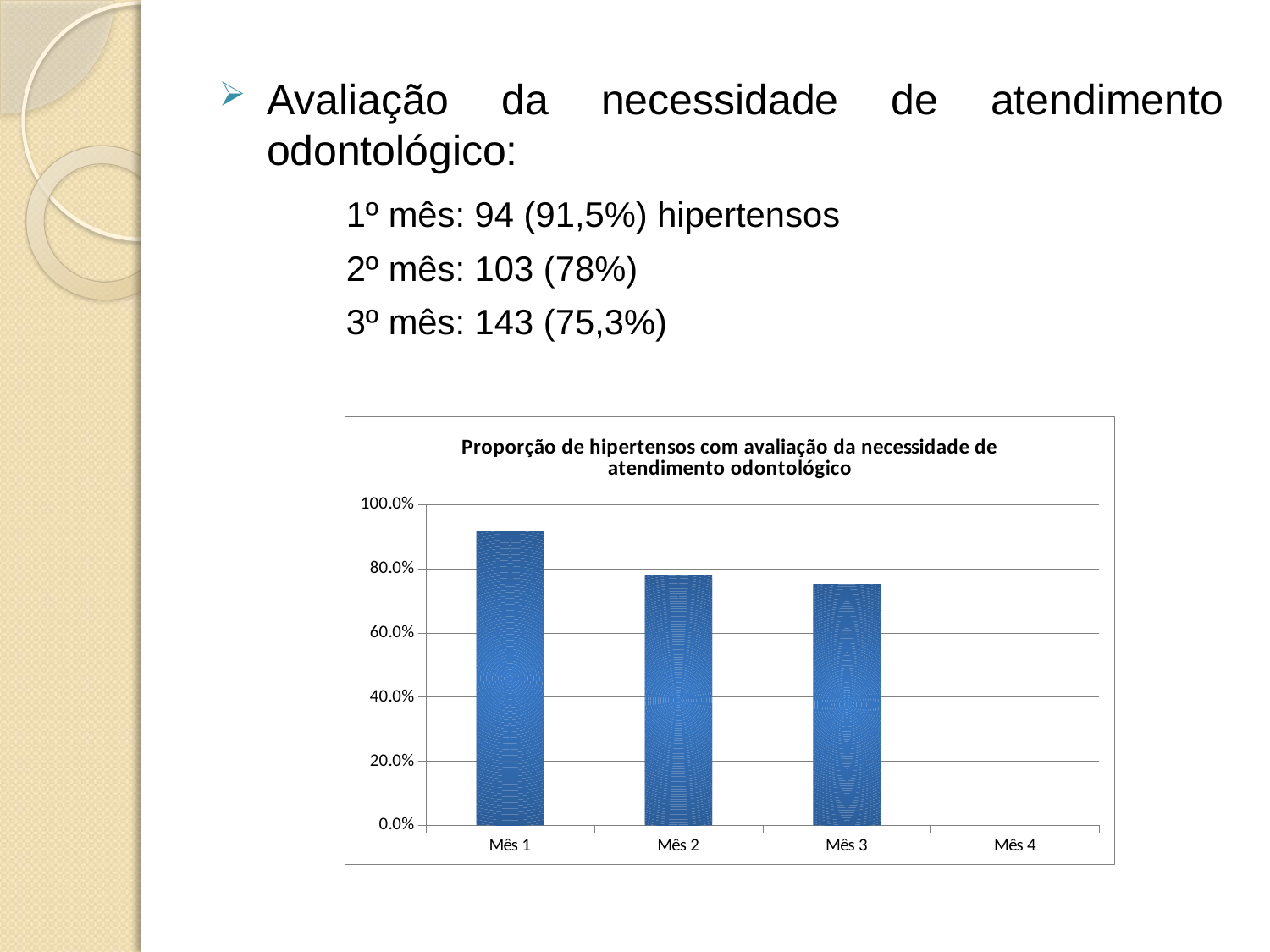
What is the title of the chart? Proporção de hipertensos com avaliação da necessidade de atendimento odontológico How many categories are labelled on the x axis of the chart? 4 Which month has the highest bar in the chart? Mês 1 Is the value for Mês 3 greater or less than 80.0%? less Is the value for Mês 1 greater or less than 80.0%? greater Is the value for Mês 3 greater or less than 60.0%? greater What is the highest value shown on the y axis of the chart? 100.0% Which is larger, the value for Mês 1 or the value for Mês 2? Mês 1 What kind of chart is shown on the slide? bar chart How many bars are actually plotted in the chart? 3 Do the bar values rise or fall from Mês 1 to Mês 3? fall